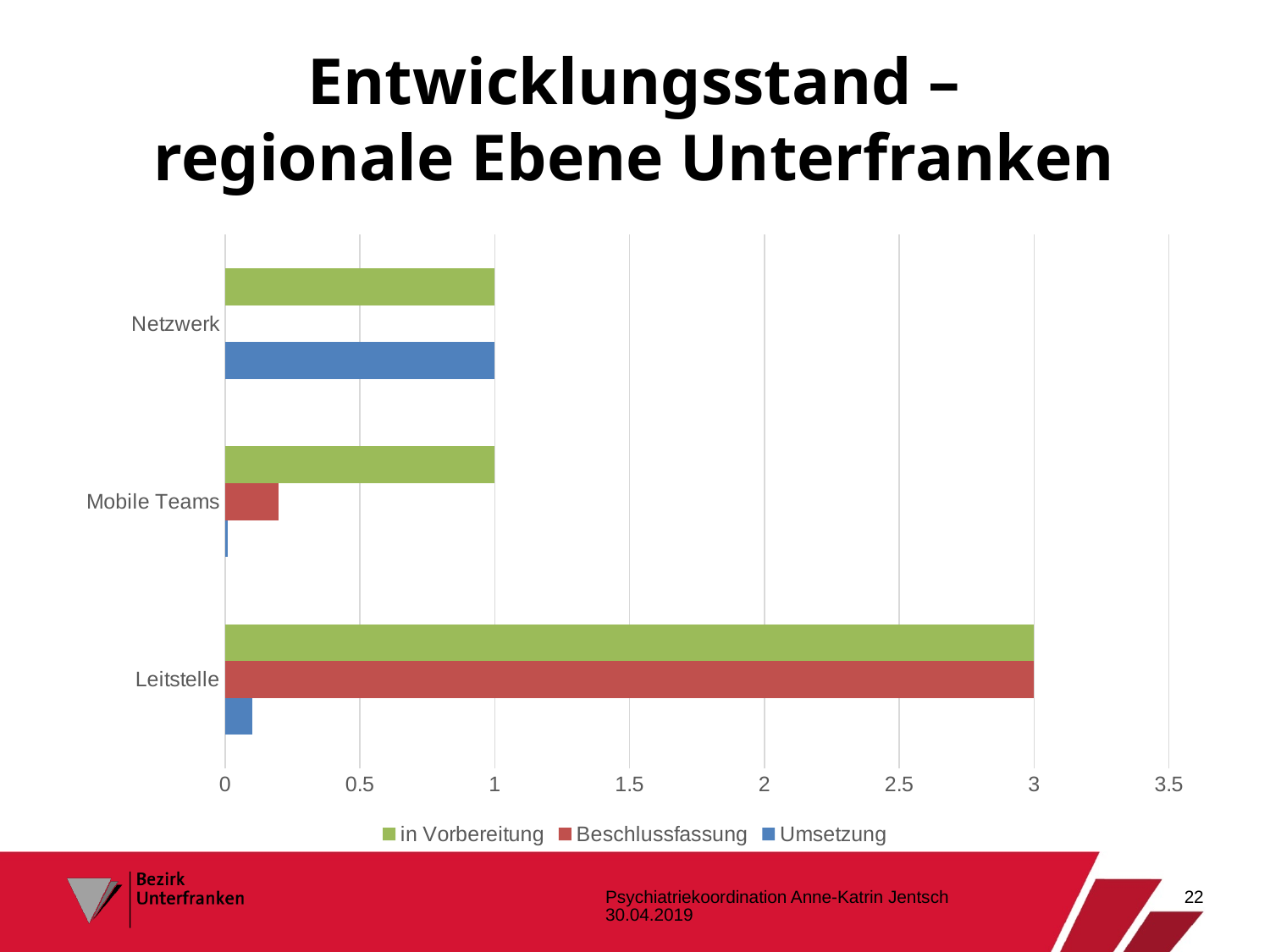
What kind of chart is shown on the slide? bar chart What is the value of 'Umsetzung' for Netzwerk? 1 What is the value of 'in Vorbereitung' for Netzwerk? 1 How many series does the legend list? 3 Which series is shown in green in the legend? in Vorbereitung What is the value of 'in Vorbereitung' for Mobile Teams? 1 Is the value of 'Beschlussfassung' for Mobile Teams greater or less than 0.5? less Which is larger: 'in Vorbereitung' for Leitstelle or 'in Vorbereitung' for Netzwerk? Leitstelle What is the value of 'Beschlussfassung' for Leitstelle? 3 Which category has the highest value for 'in Vorbereitung'? Leitstelle How many categories are shown on the vertical axis of the chart? 3 What is the value of 'in Vorbereitung' for Leitstelle? 3